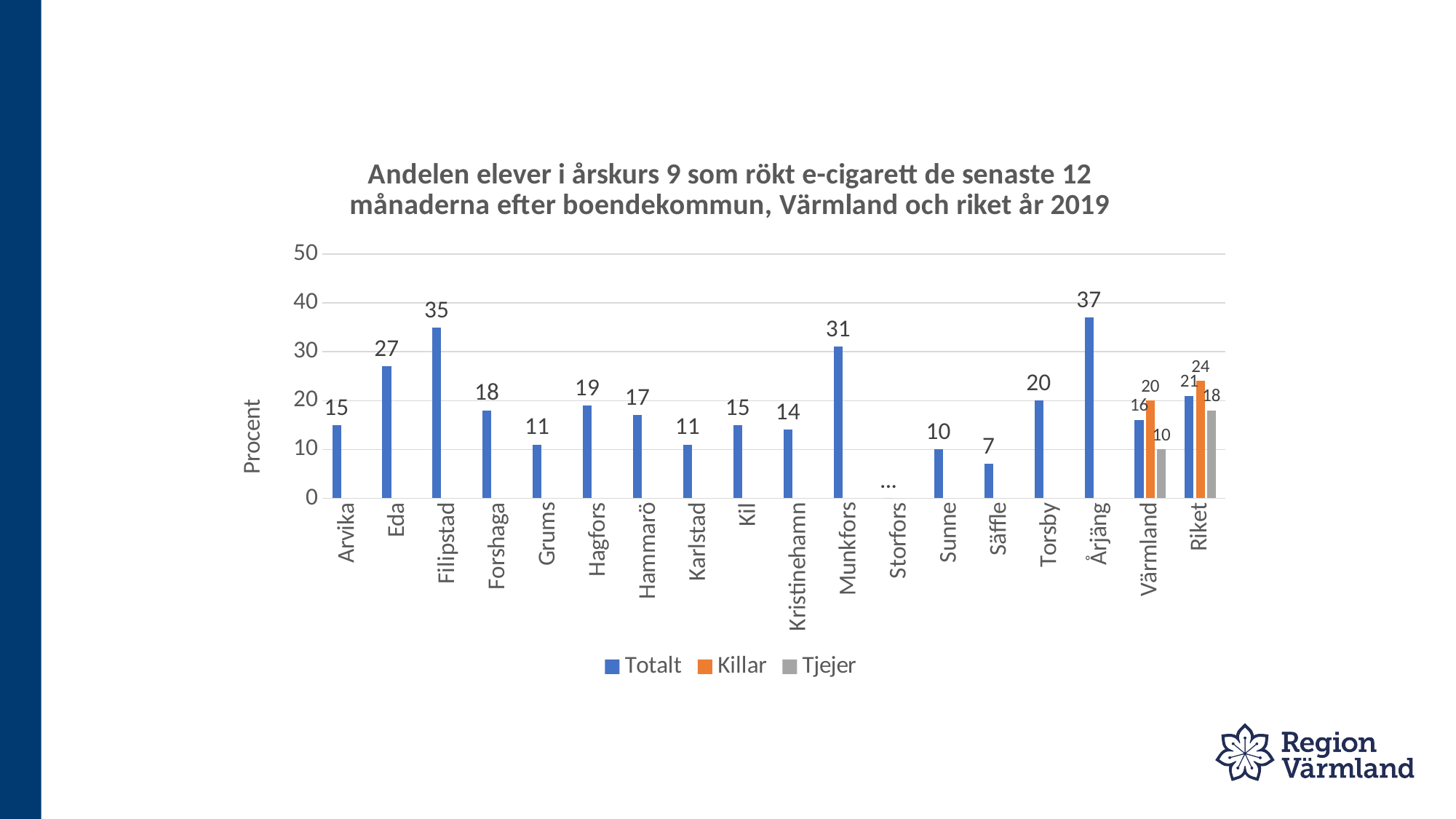
Is the Totalt value for Eda greater or less than 20? greater What is the Tjejer value for Värmland? 10 What is the Killar value for Riket? 24 Which has a higher Totalt value, Munkfors or Eda? Munkfors Which municipality has the highest Totalt value? Årjäng What is the difference between the Killar and Tjejer values for Riket? 6 What is the label of the y axis? Procent What is the difference between the Totalt values for Filipstad and Eda? 8 Which municipality has the lowest Totalt value shown on the chart? Säffle What is the Totalt value for Filipstad? 35 What kind of chart is shown on the slide? Bar chart How many series does the legend list? 3